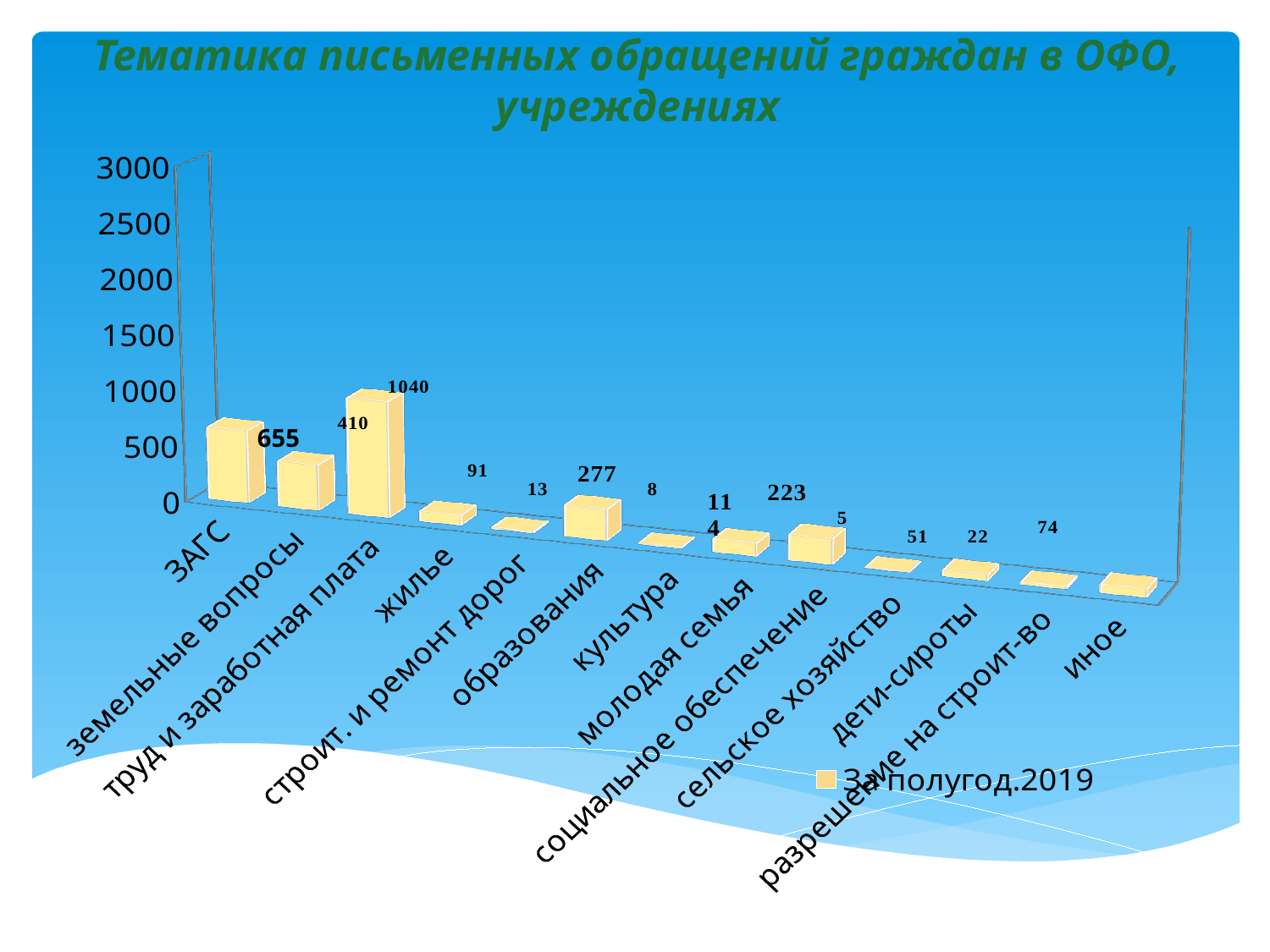
Which category has the lowest value? сельское хозяйство Which is larger, the value for ЗАГС or the value for земельные вопросы? ЗАГС What is the value for труд и заработная плата? 1040 Which category has the highest value? труд и заработная плата What kind of chart is shown on the slide? bar chart What is the difference between the values for труд и заработная плата and ЗАГС? 385 What series name does the legend show? За полугод.2019 Is the value for ЗАГС greater or less than 500? greater What is the value for социальное обеспечение? 223 What is the value for ЗАГС? 655 What is the value for образования? 277 How many categories are shown on the x axis? 13